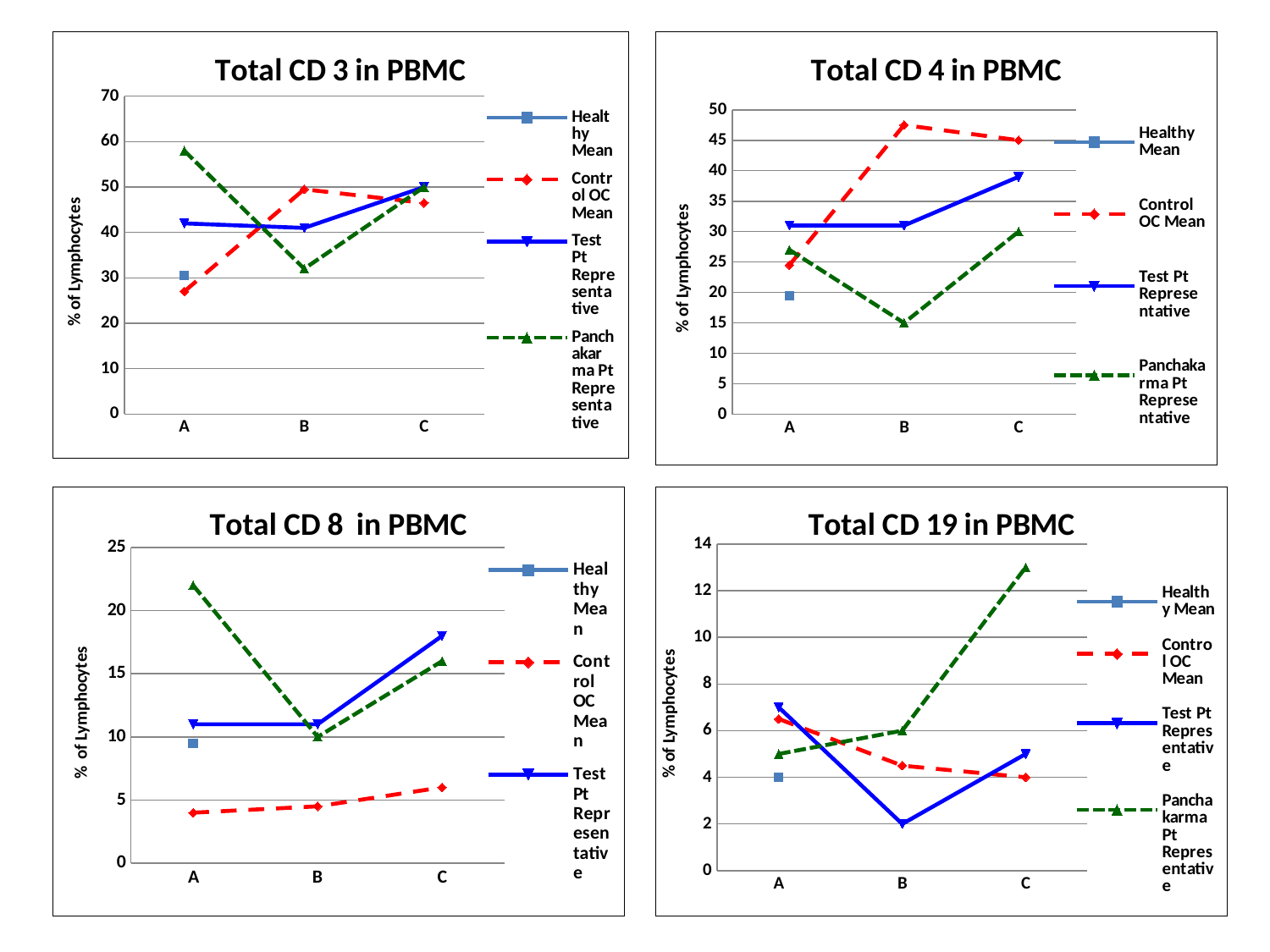
What kind of chart is "Total CD 3 in PBMC"? Line chart In the "Total CD 4 in PBMC" chart, is the value for Control OC Mean at B greater or less than 45? greater In the "Total CD 19 in PBMC" chart, at which category does Test Pt Representative reach its lowest value? B In the "Total CD 3 in PBMC" chart, does the Control OC Mean line rise or fall from A to B? rise In the "Total CD 4 in PBMC" chart, at B, which is larger: Control OC Mean or Panchakarma Pt Representative? Control OC Mean In the "Total CD 3 in PBMC" chart, how many categories are on the x axis? 3 In the "Total CD 19 in PBMC" chart, is the value for Panchakarma Pt Representative at C greater or less than 12? greater In the "Total CD 8 in PBMC" chart, how many series does the legend list? 3 In the "Total CD 8 in PBMC" chart, does the Control OC Mean line rise or fall from A to C? rise In the "Total CD 3 in PBMC" chart, is the value for Panchakarma Pt Representative at A greater or less than 50? greater In the "Total CD 3 in PBMC" chart, how many series does the legend list? 4 In the "Total CD 4 in PBMC" chart, at which category does Panchakarma Pt Representative reach its lowest value? B